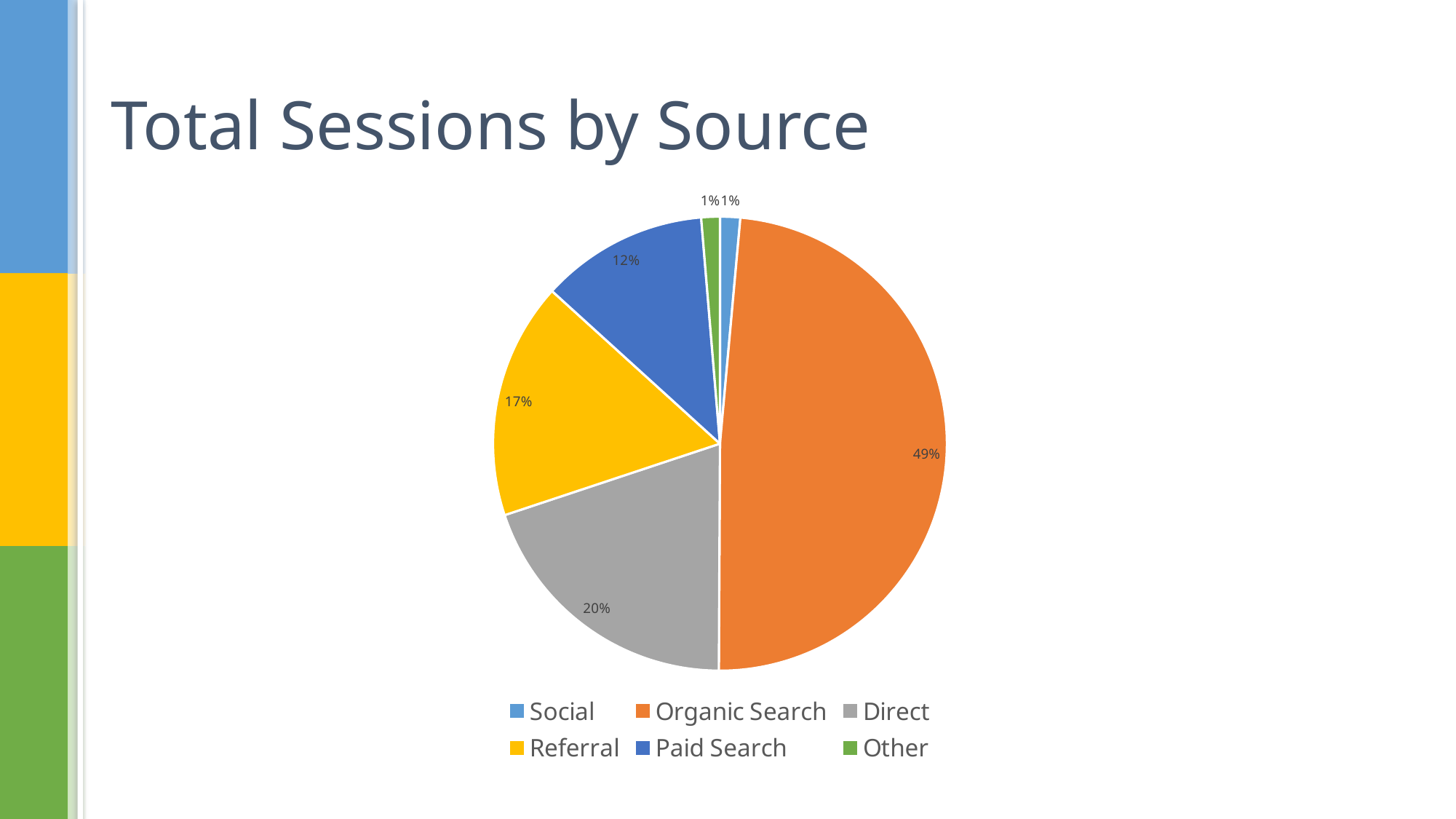
Which source has the largest share of sessions? Organic Search Which is larger, the share for Direct or the share for Referral? Direct What share of sessions comes from Paid Search? 12% What share of sessions comes from Referral? 17% What share of sessions comes from Direct? 20% How many sources are listed in the legend? 6 What is the title of the chart? Total Sessions by Source What is the difference in percentage points between the Referral share and the Paid Search share? 5 What colour is the Organic Search slice? orange What is the difference in percentage points between the Organic Search share and the Direct share? 29 What kind of chart is shown on the slide? pie chart